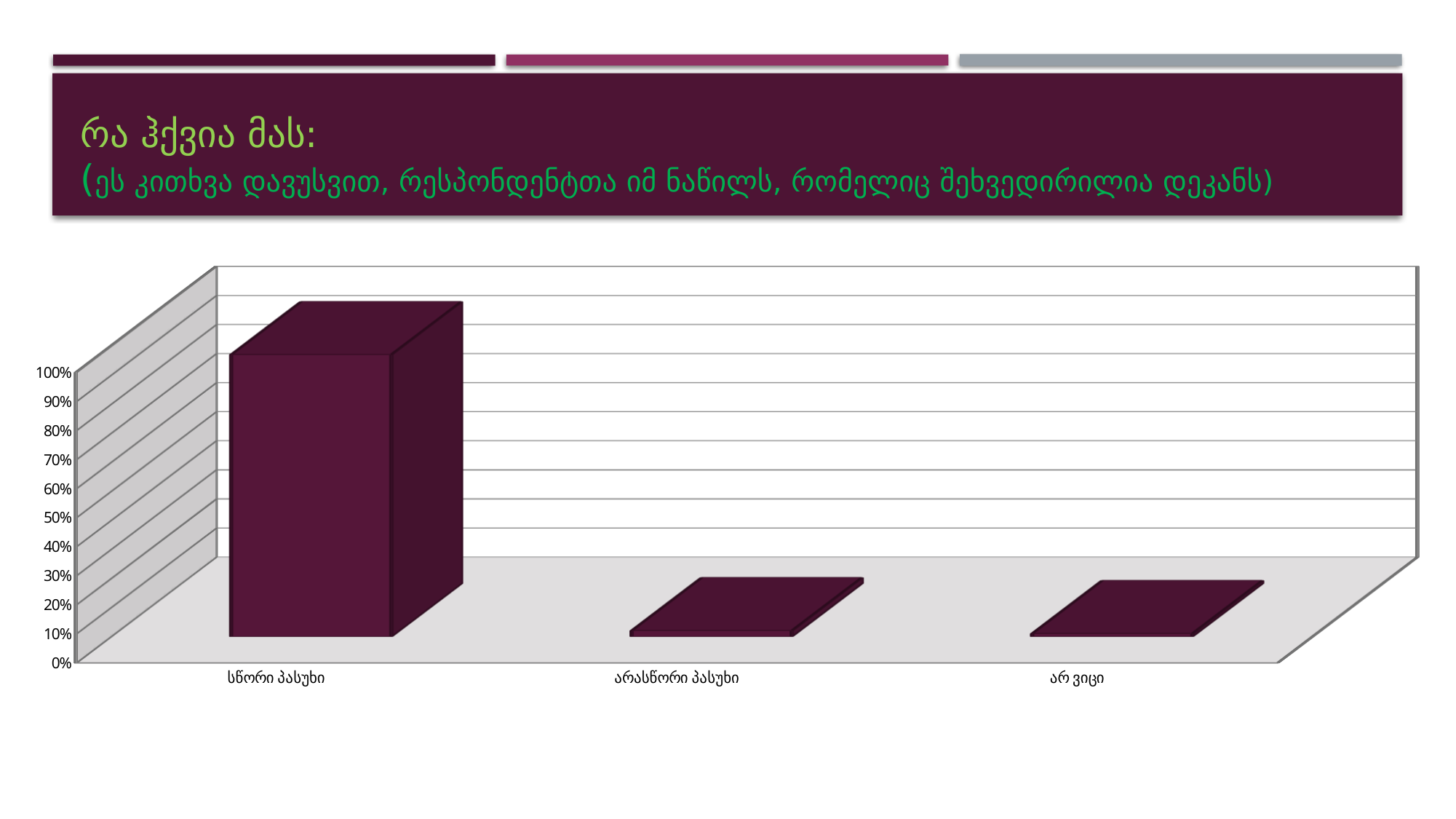
Which is larger, the value for სწორი პასუხი or the value for არ ვიცი? სწორი პასუხი Is the value for არ ვიცი greater or less than 10%? less Which category has the highest value in the chart? სწორი პასუხი What is the label of the first category on the x axis of the chart? სწორი პასუხი Is the value for არასწორი პასუხი greater or less than 10%? less What is the highest tick value shown on the vertical axis of the chart? 100% Is the value for სწორი პასუხი greater or less than 90%? greater Which is larger, the value for სწორი პასუხი or the value for არასწორი პასუხი? სწორი პასუხი What kind of chart is shown on the slide? bar chart How many categories are shown on the x axis of the chart? 3